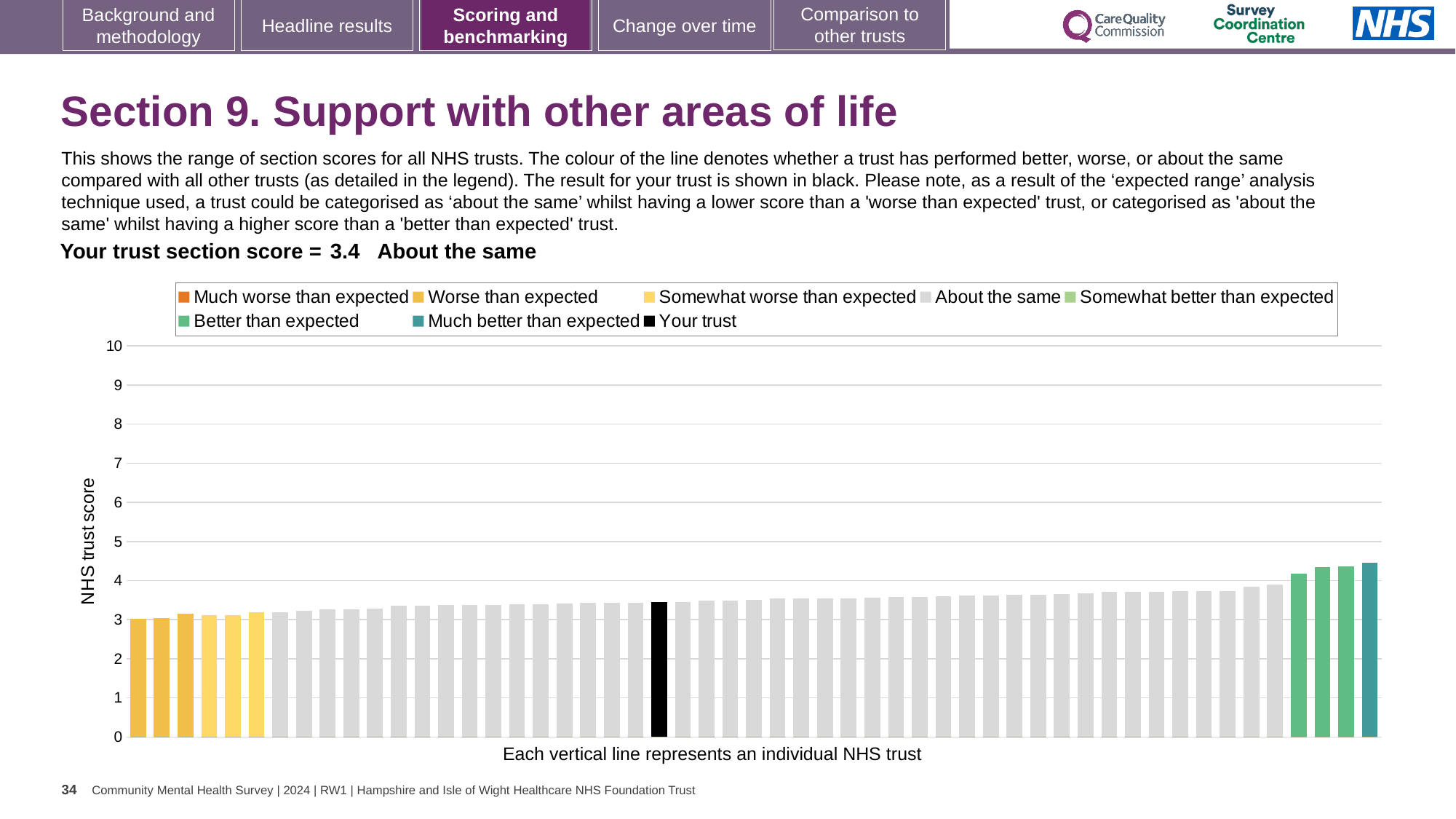
Which legend category does the highest-scoring trust bar belong to? Much better than expected Is the value of the leftmost (lowest) bar greater or less than 4? less What is the label on the vertical axis of the chart? NHS trust score What type of chart is shown on the slide? bar chart How many entries does the chart legend list? 8 What is the section score for your trust shown on the slide? 3.4 Is the value for your trust (the black bar) greater or less than 4? less Is the value of the rightmost (highest) bar greater or less than 4? greater What colour is used for the bar representing your trust? black Which performance category is your trust's section score placed in? About the same Do the trust scores rise or fall moving from left to right along the x axis? rise